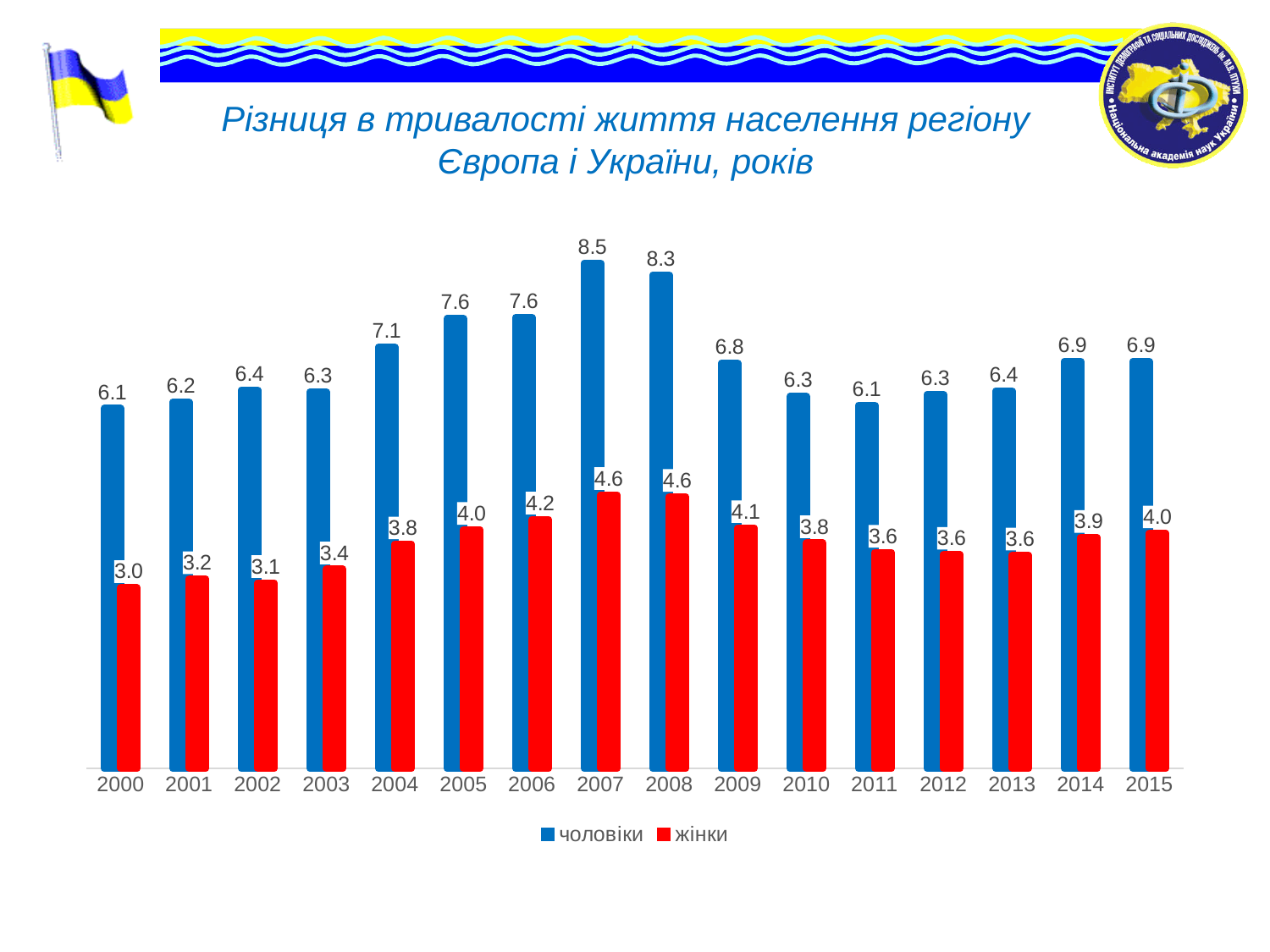
In which year is the value for жінки lowest? 2000 What is the difference between the чоловіки and жінки values in 2007? 3.9 What is the value for жінки in 2012? 3.6 What is the value for чоловіки in 2004? 7.1 How many series does the legend list? 2 In which year is the value for чоловіки highest? 2007 What is the value for жінки in 2000? 3.0 What is the value for чоловіки in 2007? 8.5 Which is larger: the чоловіки value in 2008 or the чоловіки value in 2009? 2008 What type of chart is shown on the slide? bar chart How many years are shown on the x axis? 16 Which series is shown in red in the legend? жінки